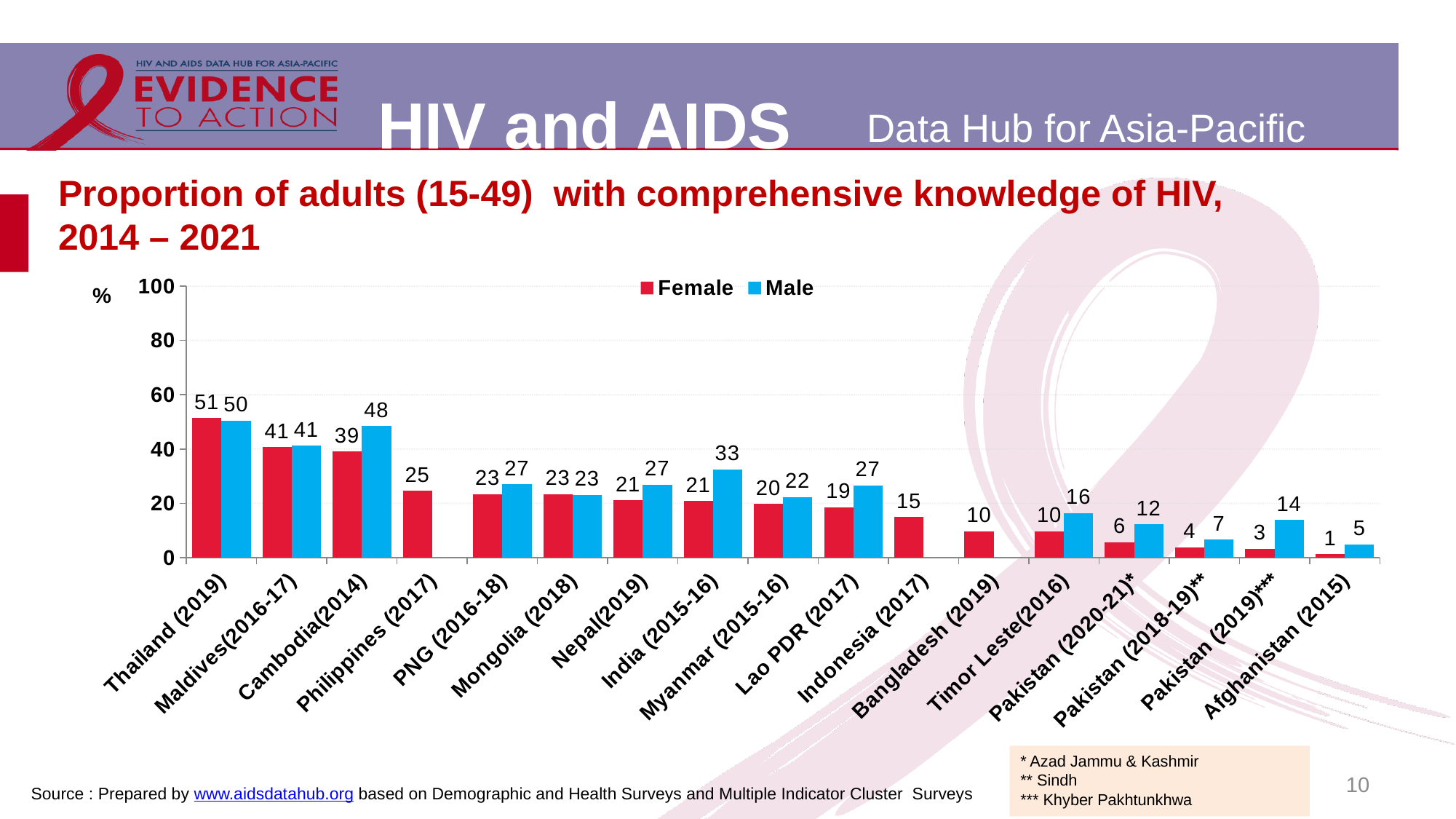
Which country has the lowest Male value? Afghanistan (2015) What colour represents the Male series? Blue How many countries/categories are shown on the x axis? 17 What is the difference between the Male and Female values for India (2015-16)? 12 What is the Female value for Thailand (2019)? 51 Which country has the highest Female value? Thailand (2019) How many series does the legend list? 2 What is the Female value for Afghanistan (2015)? 1 What is the Male value for Cambodia (2014)? 48 What is the Male value for India (2015-16)? 33 Which is larger for Pakistan (2019)***, the Female value or the Male value? Male What kind of chart is shown on the slide? Bar chart